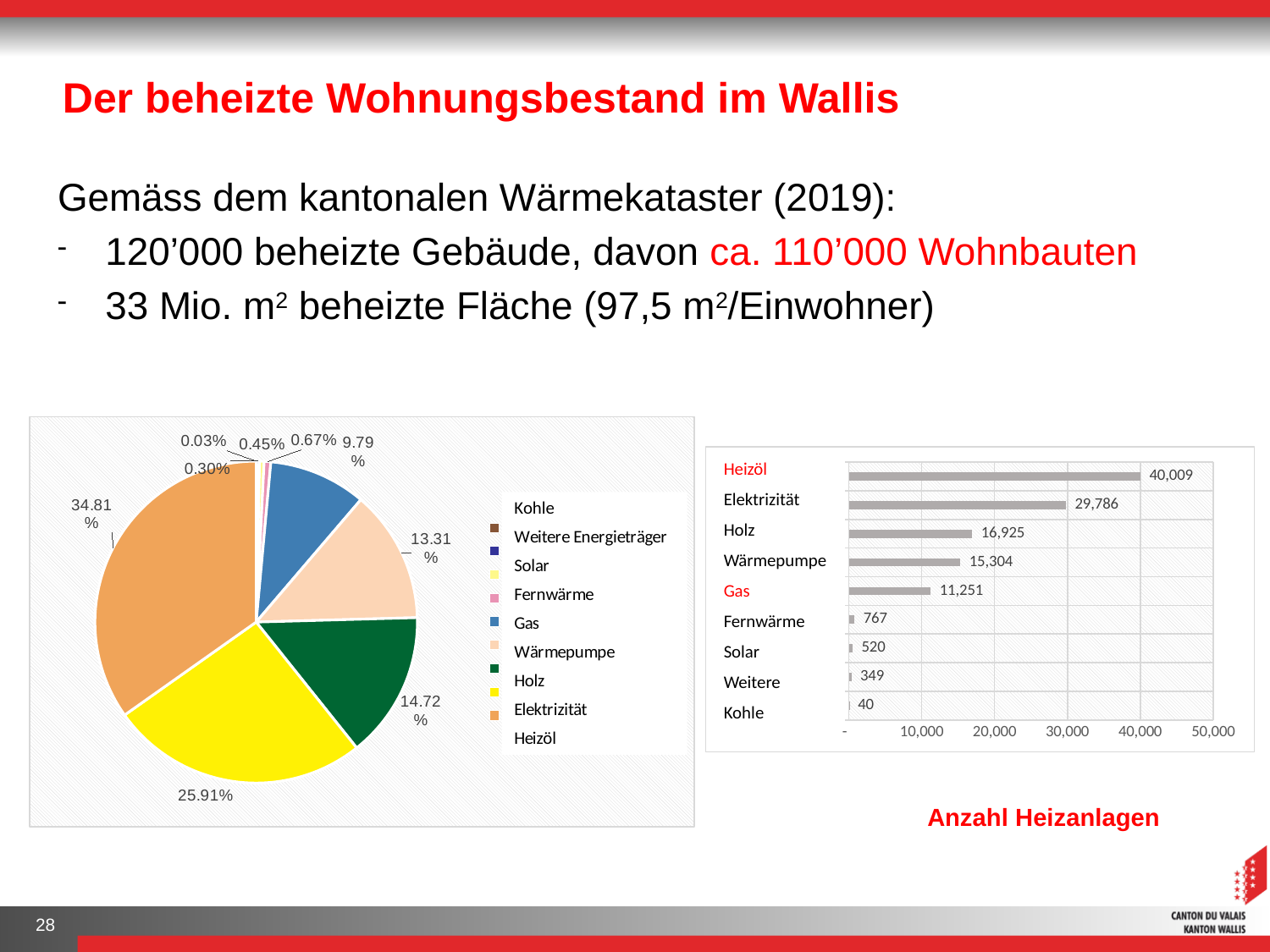
What kind of chart is the chart on the right of the slide? bar chart How many categories does the bar chart 'Anzahl Heizanlagen' show? 9 In the bar chart 'Anzahl Heizanlagen', what is the value for Wärmepumpe? 15,304 In the bar chart 'Anzahl Heizanlagen', what is the value for Heizöl? 40,009 In the pie chart on the left, which slice is larger, Holz or Gas? Holz In the bar chart 'Anzahl Heizanlagen', which category has the lowest value? Kohle In the bar chart 'Anzahl Heizanlagen', which is larger, Holz or Gas? Holz In the bar chart 'Anzahl Heizanlagen', which category has the highest value? Heizöl In the bar chart 'Anzahl Heizanlagen', what is the difference between Heizöl and Elektrizität? 10,223 In the pie chart on the left, what share does the Elektrizität slice have? 25.91% In the pie chart on the left, what share does the Heizöl slice have? 34.81% How many entries does the legend of the pie chart on the left list? 9